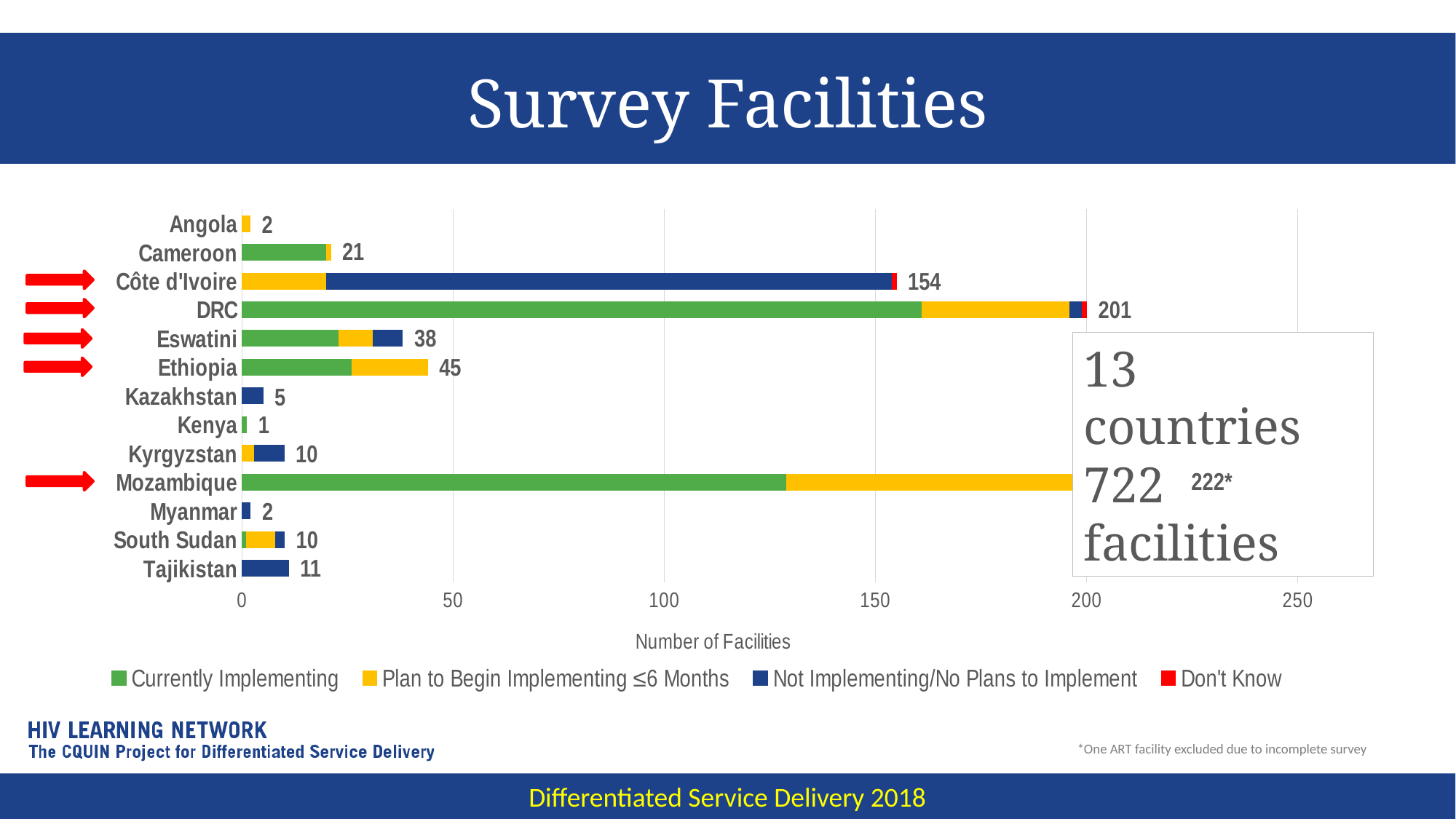
What is the difference between the total facilities for DRC and Côte d'Ivoire? 47 What is the total number of facilities shown for Côte d'Ivoire? 154 Is the Currently Implementing value for Mozambique greater or less than 100? greater What is the total number of facilities shown for DRC? 201 Which has more total facilities, Eswatini or Ethiopia? Ethiopia What kind of chart is shown on the slide? Stacked bar chart How many series does the legend list? 4 Which country has the highest total number of facilities? Mozambique What is the total number of facilities shown for Ethiopia? 45 How many countries are shown on the chart? 13 What is the title of the horizontal axis? Number of Facilities Which country has the lowest total number of facilities? Kenya